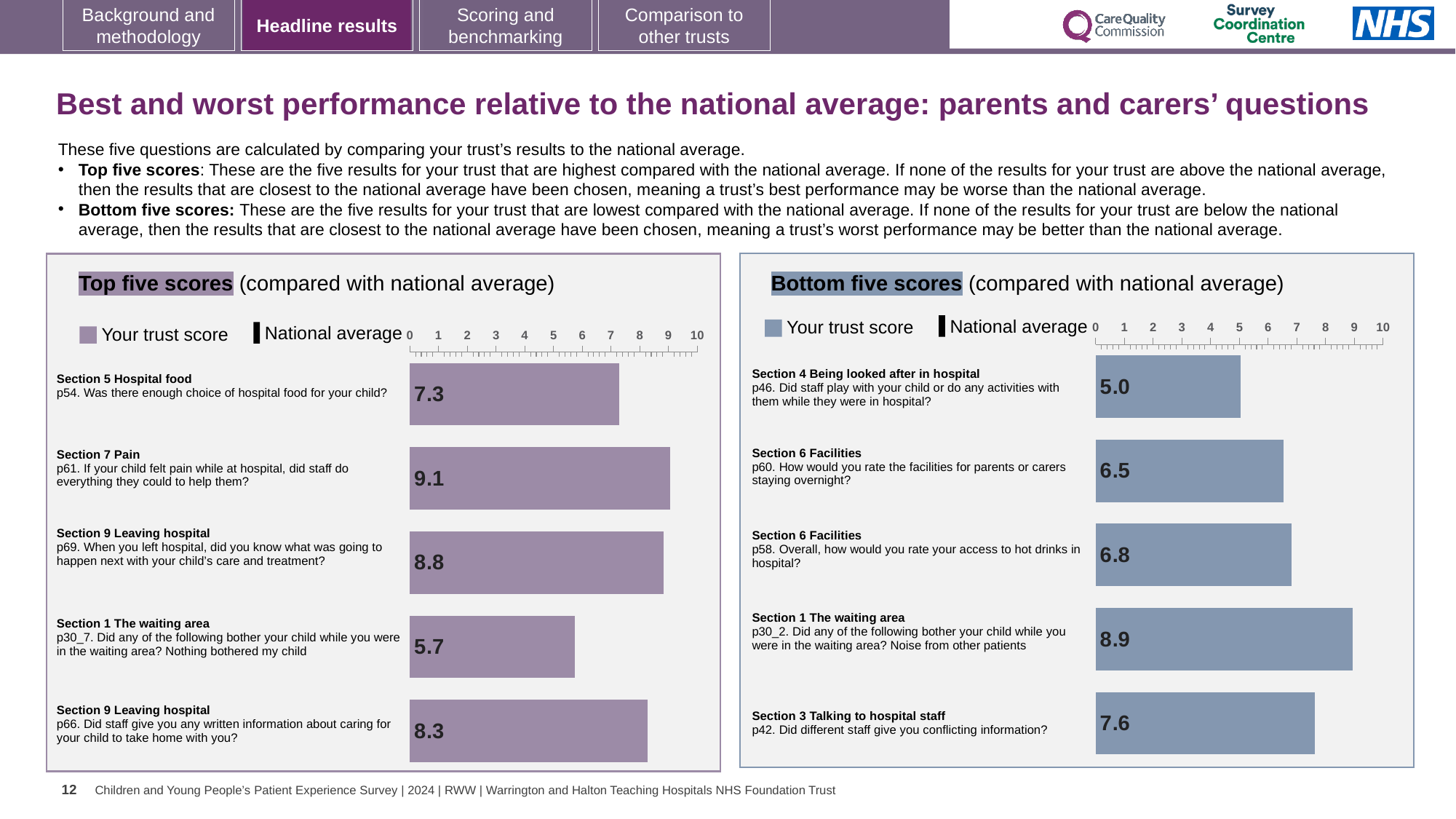
How many series does the legend of the Top five scores chart list? 2 In the Bottom five scores chart, which question has the lowest trust score? p46. Did staff play with your child or do any activities with them while they were in hospital? In the Bottom five scores chart, what is the difference between the trust scores for p58 and p46? 1.8 In the Top five scores chart, what is the trust score for p54 (Was there enough choice of hospital food for your child?)? 7.3 In the Top five scores chart, which question has the lowest trust score? p30_7. Did any of the following bother your child while you were in the waiting area? Nothing bothered my child In the Top five scores chart, which question has the highest trust score? p61. If your child felt pain while at hospital, did staff do everything they could to help them? In the Bottom five scores chart, what is the trust score for p60 (How would you rate the facilities for parents or carers staying overnight?)? 6.5 How many questions are shown in the Bottom five scores chart? 5 Which is larger: the trust score for p69 in the Top five scores chart or the trust score for p42 in the Bottom five scores chart? p69 in the Top five scores chart In the Bottom five scores chart, which question has the highest trust score? p30_2. Did any of the following bother your child while you were in the waiting area? Noise from other patients What type of chart is the Top five scores chart? Bar chart In the Top five scores chart, what is the difference between the trust scores for p61 and p66? 0.8